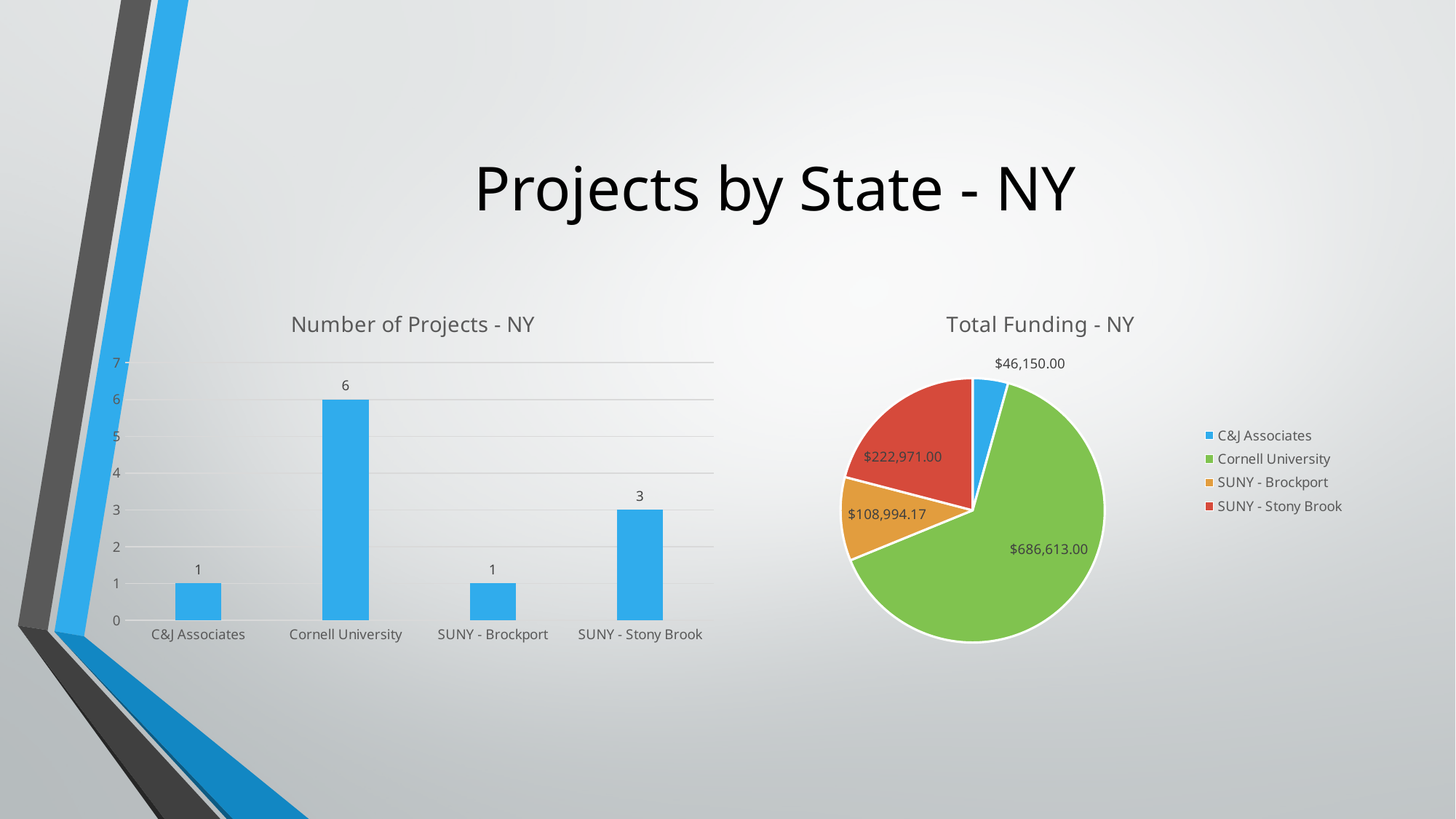
What kind of chart is the Number of Projects - NY chart? bar chart In the Number of Projects - NY chart, how many categories are shown on the x axis? 4 In the Number of Projects - NY chart, which category has the highest number of projects? Cornell University In the Total Funding - NY chart, what colour is the slice for Cornell University? green In the Total Funding - NY chart, what is the difference between the funding for SUNY - Stony Brook and SUNY - Brockport? $113,976.83 In the Number of Projects - NY chart, how many projects does Cornell University have? 6 In the Number of Projects - NY chart, what is the difference between the number of projects for Cornell University and SUNY - Stony Brook? 3 In the Total Funding - NY chart, what is the funding value for Cornell University? $686,613.00 In the Total Funding - NY chart, what is the funding value for SUNY - Brockport? $108,994.17 In the Total Funding - NY chart, which category has the smallest slice? C&J Associates In the Total Funding - NY chart, which is larger, the funding for SUNY - Stony Brook or SUNY - Brockport? SUNY - Stony Brook In the Number of Projects - NY chart, how many projects does SUNY - Stony Brook have? 3